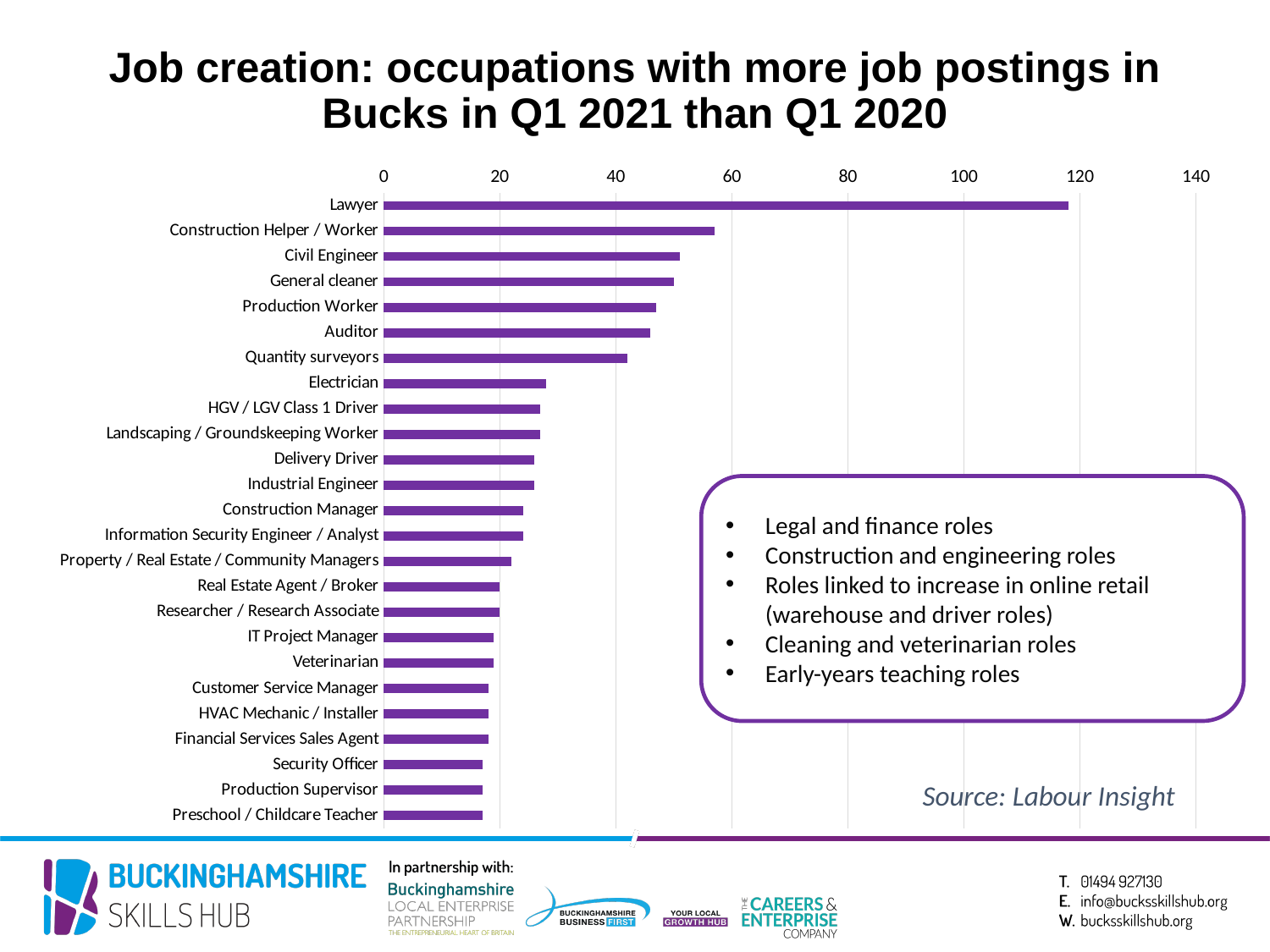
Is the value for Preschool / Childcare Teacher greater or less than 20? less Which has a larger value, Lawyer or Civil Engineer? Lawyer Which occupation has the highest value in the chart? Lawyer What source is cited for the chart data? Labour Insight Is the value for Civil Engineer greater or less than 40? greater Which has a larger value, Construction Helper / Worker or Electrician? Construction Helper / Worker Do the bar values increase or decrease going from the top of the chart to the bottom? decrease What kind of chart is shown on the slide? bar chart Is the value for Electrician greater or less than 40? less How many occupations are listed in the chart? 25